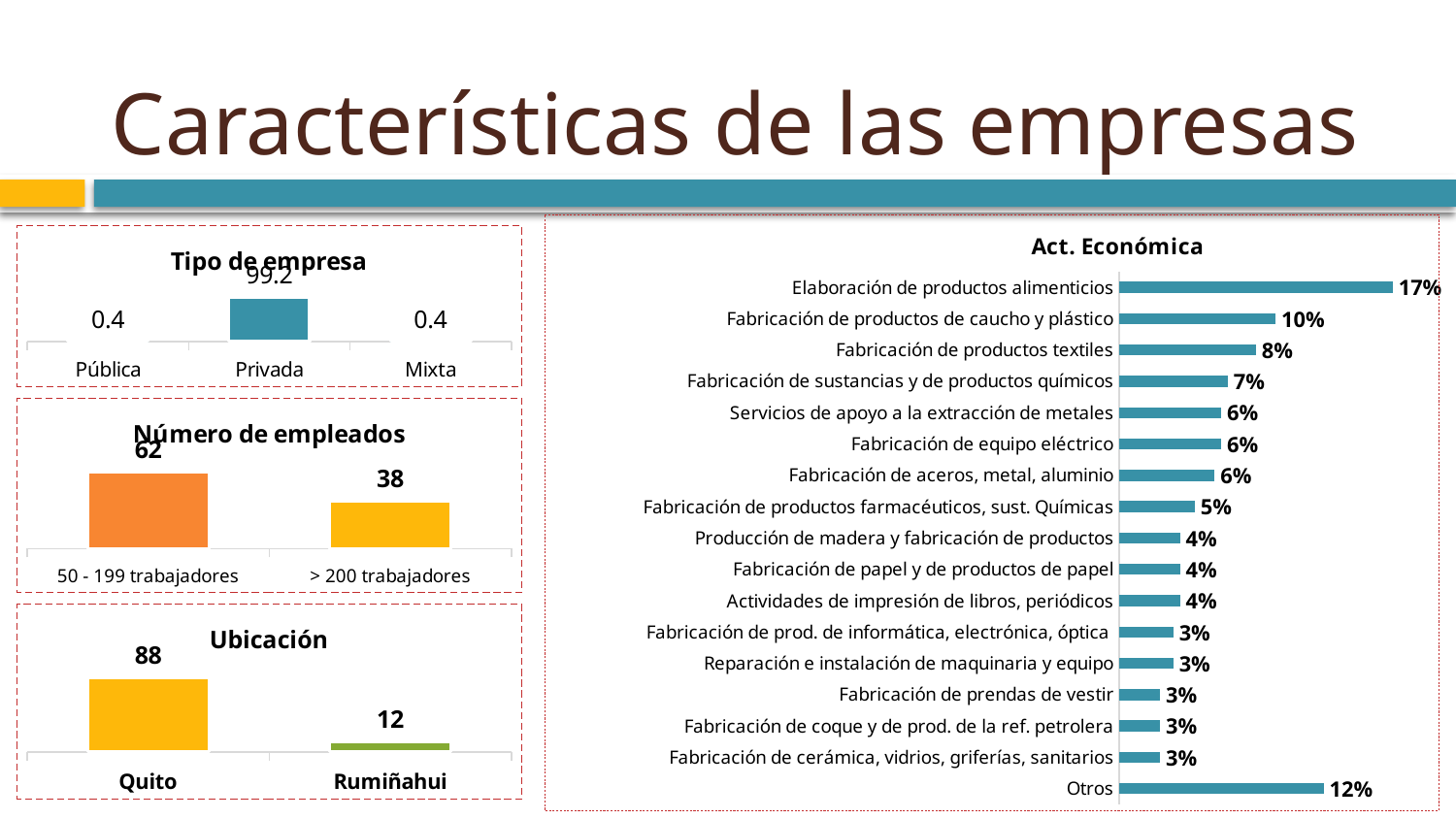
In the 'Número de empleados' chart, what is the value for '50 - 199 trabajadores'? 62 In the 'Tipo de empresa' chart, what is the value for Pública? 0.4 In the 'Ubicación' chart, which category has the highest value? Quito In the 'Act. Económica' chart, what is the value for 'Fabricación de productos de caucho y plástico'? 10% In the 'Ubicación' chart, what is the value for Rumiñahui? 12 In the 'Número de empleados' chart, what is the difference between the values for '50 - 199 trabajadores' and '> 200 trabajadores'? 24 In the 'Tipo de empresa' chart, what is the value for Privada? 99.2 What kind of chart is the 'Act. Económica' chart? Bar chart In the 'Act. Económica' chart, which category has the highest value? Elaboración de productos alimenticios In the 'Act. Económica' chart, what is the difference between the values for 'Elaboración de productos alimenticios' and 'Fabricación de sustancias y de productos químicos'? 10% In the 'Act. Económica' chart, how many categories are plotted? 17 In the 'Act. Económica' chart, which is larger: the value for 'Otros' or the value for 'Fabricación de productos textiles'? Otros